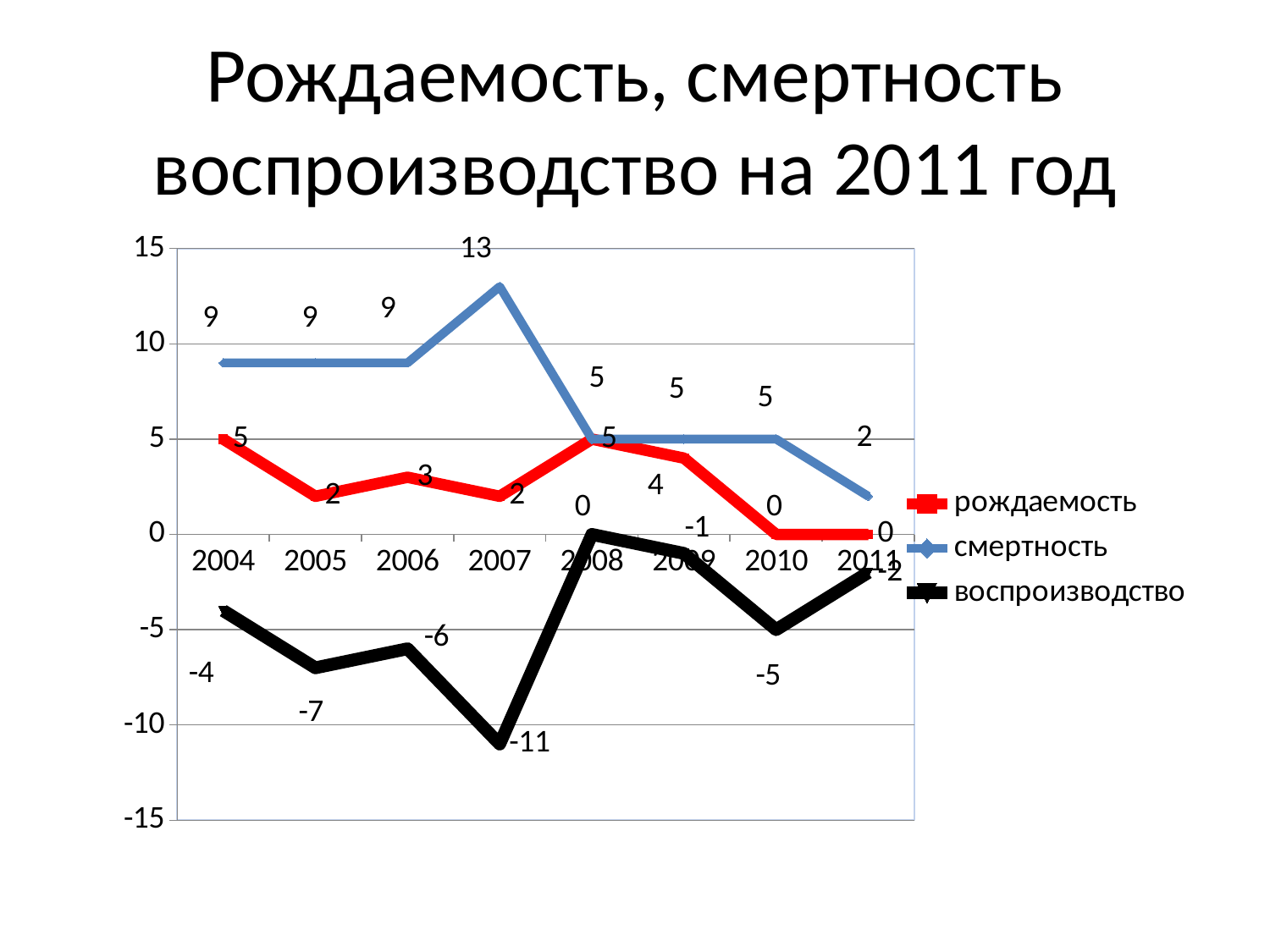
What is the difference between смертность and рождаемость in 2004? 4 Which series is drawn in black? воспроизводство In which year is воспроизводство lowest? 2007 How many series does the legend list? 3 Does смертность rise or fall from 2007 to 2011? fall In which year is смертность highest? 2007 What type of chart is shown on the slide? line chart How many years are shown on the x axis? 8 What is the value of рождаемость in 2009? 4 What is the value of смертность in 2007? 13 Which is larger in 2011, смертность or рождаемость? смертность What is the value of воспроизводство in 2007? -11